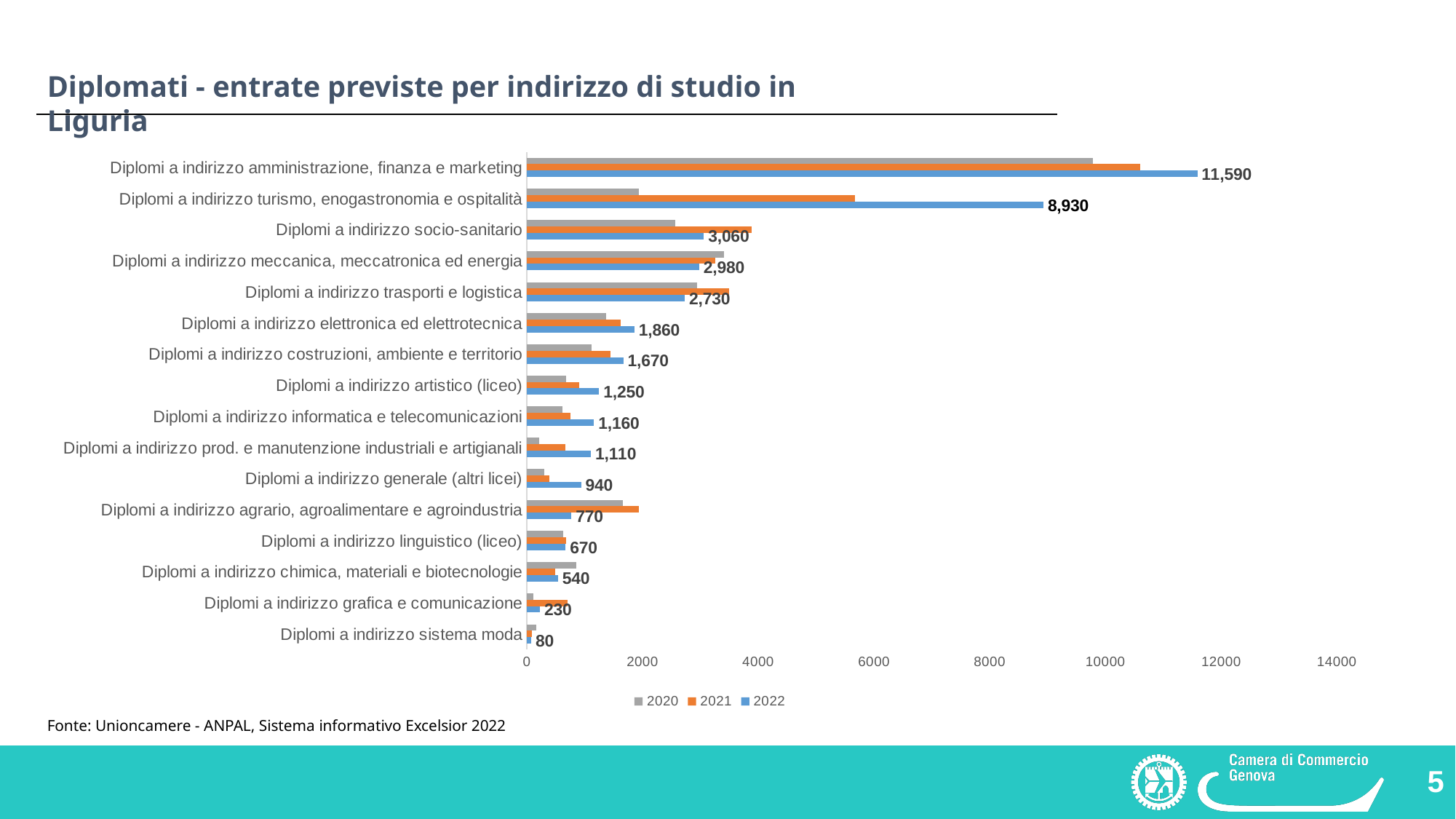
What kind of chart is shown on the slide? bar chart Which category has the highest 2022 value? Diplomi a indirizzo amministrazione, finanza e marketing Is the 2021 value for Diplomi a indirizzo turismo, enogastronomia e ospitalità greater or less than 4000? greater Is the 2020 value for Diplomi a indirizzo amministrazione, finanza e marketing greater or less than 8000? greater What is the 2022 value for Diplomi a indirizzo sistema moda? 80 Which has the larger 2022 value: Diplomi a indirizzo elettronica ed elettrotecnica or Diplomi a indirizzo costruzioni, ambiente e territorio? Diplomi a indirizzo elettronica ed elettrotecnica Which category has the lowest 2022 value? Diplomi a indirizzo sistema moda What is the 2022 value for Diplomi a indirizzo turismo, enogastronomia e ospitalità? 8,930 How many categories (study tracks) are shown in the chart? 16 How many series does the legend list? 3 What is the 2022 value for Diplomi a indirizzo amministrazione, finanza e marketing? 11,590 What is the difference between the 2022 values for amministrazione, finanza e marketing and turismo, enogastronomia e ospitalità? 2,660